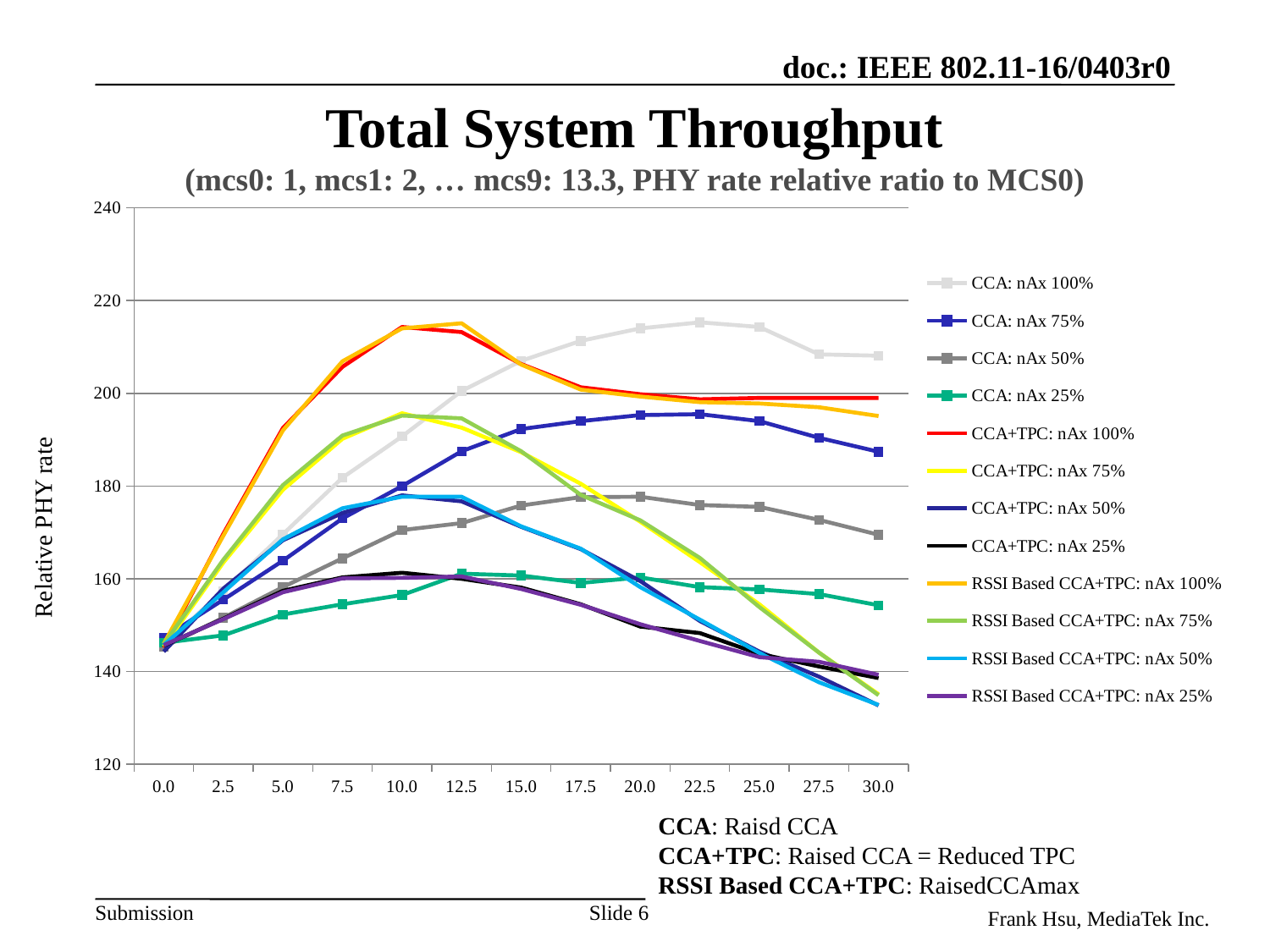
What is the label on the vertical axis of the chart? Relative PHY rate At x = 30.0, which is larger: CCA: nAx 100% or CCA+TPC: nAx 100%? CCA: nAx 100% How many x-axis points are plotted for each series (from 0.0 to 30.0)? 13 Is the value for CCA+TPC: nAx 100% at x = 10.0 greater or less than 200? greater Is the value for CCA: nAx 25% at x = 30.0 greater or less than 160? less Is the value for RSSI Based CCA+TPC: nAx 50% at x = 30.0 greater or less than 140? less Does the CCA: nAx 100% series rise or fall from x = 0.0 to x = 22.5? rise Does the RSSI Based CCA+TPC: nAx 75% series rise or fall from x = 10.0 to x = 30.0? fall Which series has the highest value at x = 30.0? CCA: nAx 100% What kind of chart is shown on the slide? line chart How many series does the legend list? 12